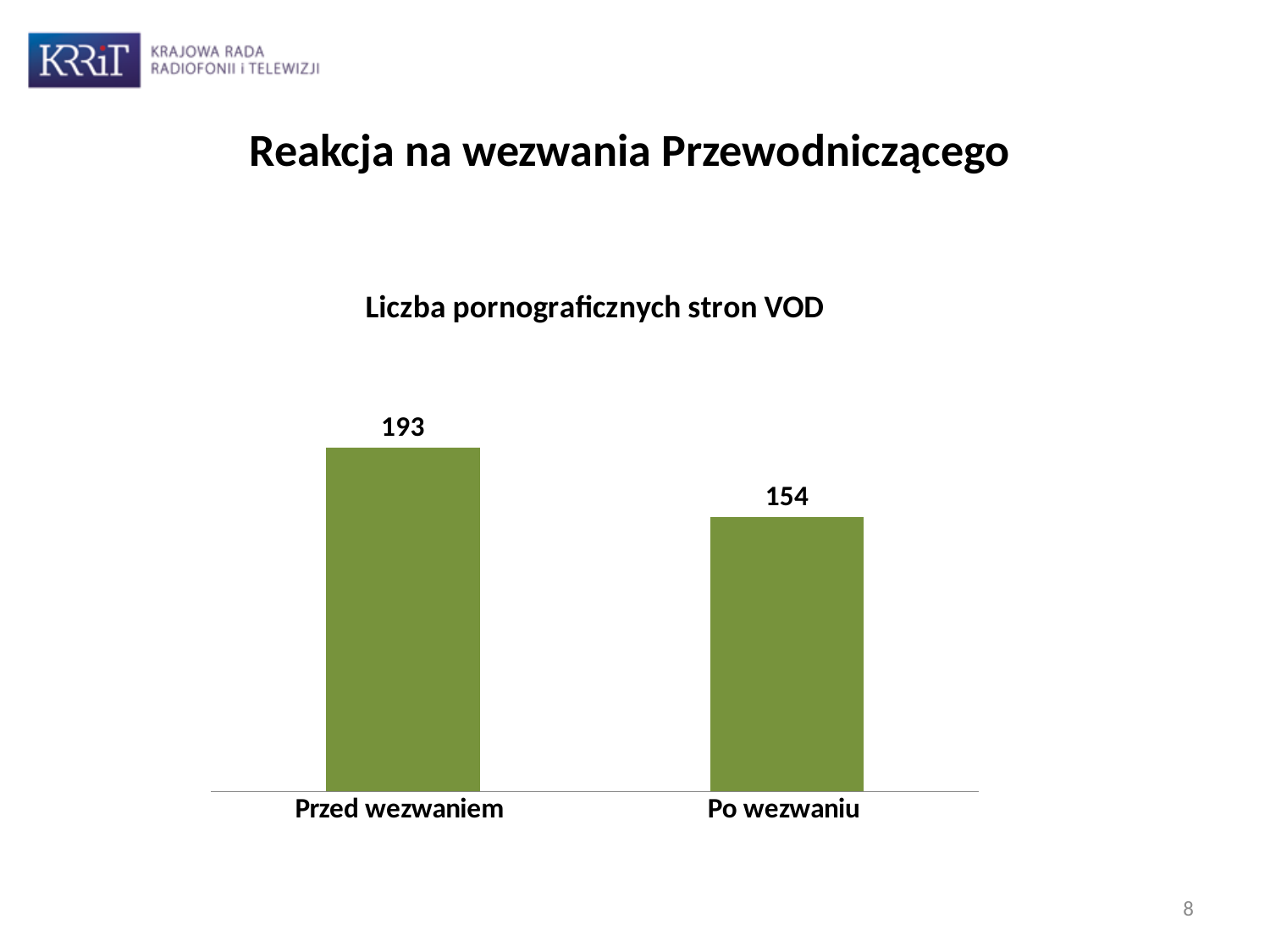
What is the title of the chart? Liczba pornograficznych stron VOD What colour are the bars in the chart? Green What is the value for "Po wezwaniu"? 154 How many categories are shown in the chart? 2 What is the value for "Przed wezwaniem"? 193 Which category has the lowest value? Po wezwaniu What kind of chart is shown on the slide? Bar chart Which category has the highest value? Przed wezwaniem Which is larger, the value for "Przed wezwaniem" or for "Po wezwaniu"? Przed wezwaniem What is the difference between the values for "Przed wezwaniem" and "Po wezwaniu"? 39 Do the values rise or fall from left to right along the x axis? Fall